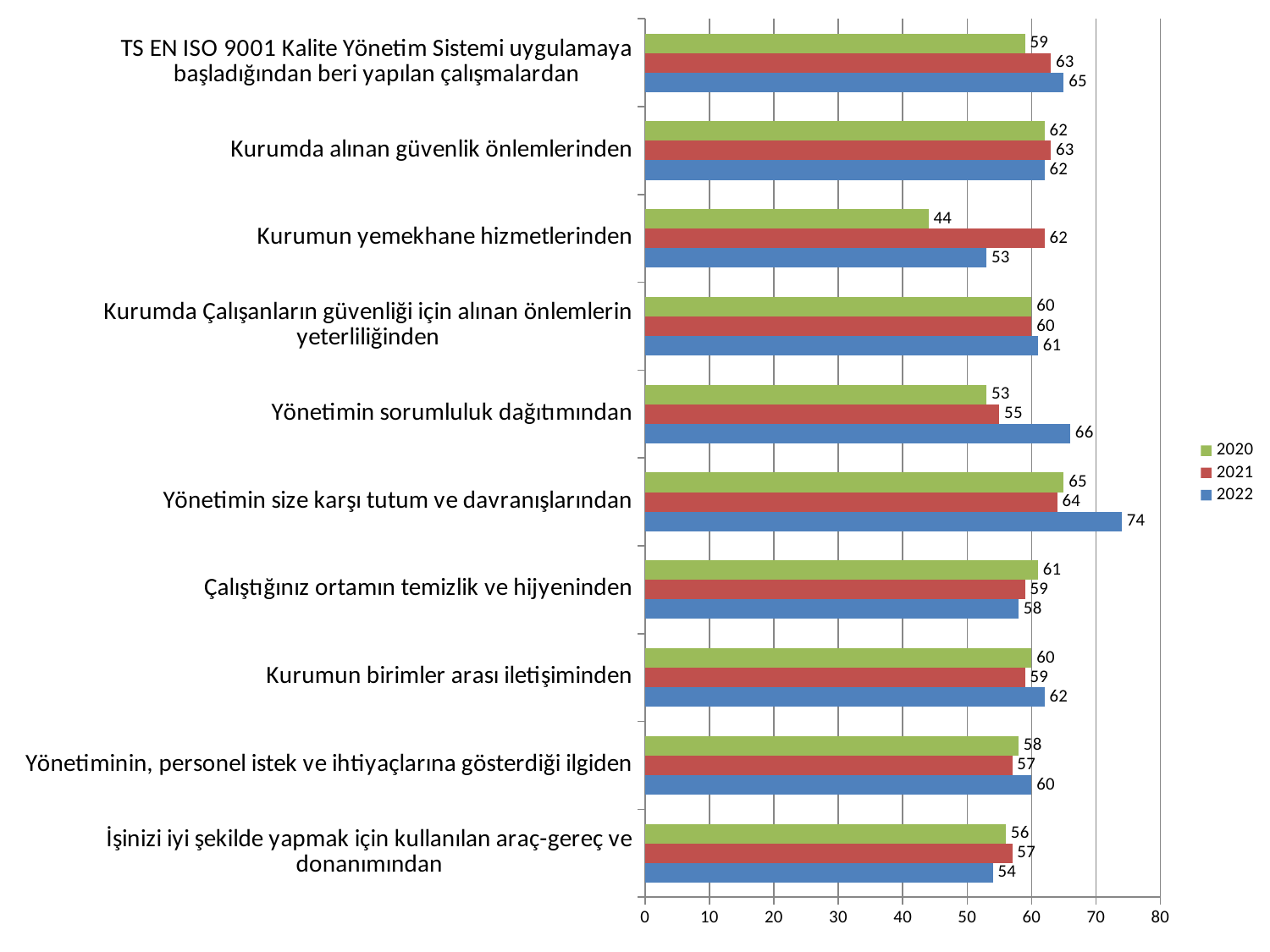
Is the 2022 value for "Yönetimin size karşı tutum ve davranışlarından" greater or less than 70? greater Which category has the highest 2022 value? Yönetimin size karşı tutum ve davranışlarından How many categories are shown on the chart? 10 What is the 2020 value for "Yönetimin sorumluluk dağıtımından"? 53 What is the difference between the 2022 and 2021 values for "Yönetimin size karşı tutum ve davranışlarından"? 10 What is the 2022 value for "Kurumun yemekhane hizmetlerinden"? 53 Which category has the lowest 2020 value? Kurumun yemekhane hizmetlerinden For "Çalıştığınız ortamın temizlik ve hijyeninden", which is larger: the 2020 value or the 2022 value? 2020 How many series does the legend list? 3 What is the difference between the 2021 and 2020 values for "Kurumun yemekhane hizmetlerinden"? 18 What is the 2021 value for "TS EN ISO 9001 Kalite Yönetim Sistemi uygulamaya başladığından beri yapılan çalışmalardan"? 63 What kind of chart is shown on the slide? Bar chart